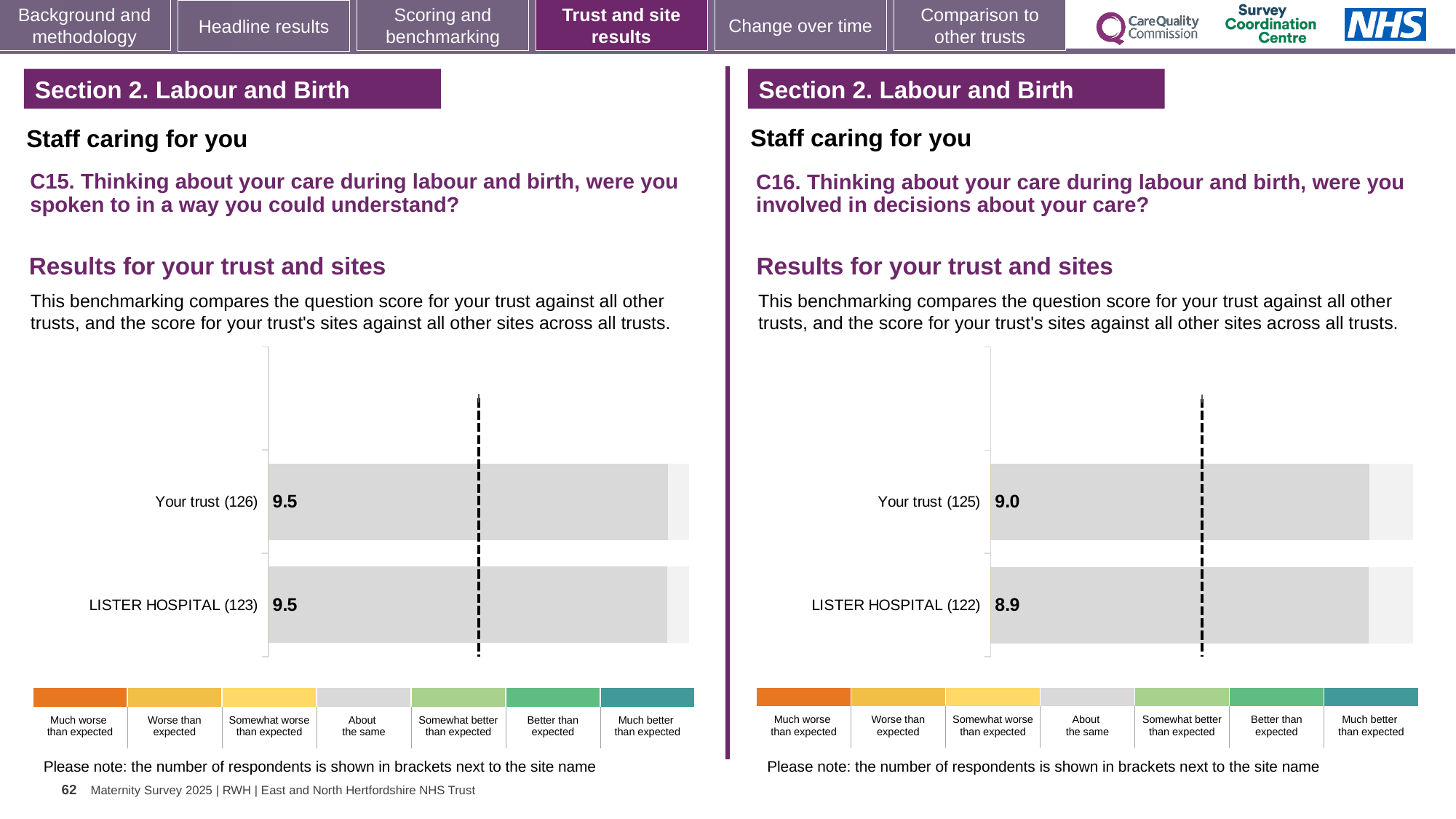
How many bars are plotted on the right chart (C16)? 2 On the right chart (C16), how many respondents are shown in brackets for Your trust? 125 On the right chart (C16), what is the score for LISTER HOSPITAL? 8.9 On the right chart (C16), what is the difference between the score for Your trust and the score for LISTER HOSPITAL? 0.1 On the right chart (C16), which has the higher score, Your trust or LISTER HOSPITAL? Your trust On the left chart (C15), what is the score for Your trust? 9.5 What kind of chart is used on the left (C15)? Bar chart On the left chart (C15), what is the difference between the score for Your trust and the score for LISTER HOSPITAL? 0 On the left chart (C15), what is the score for LISTER HOSPITAL? 9.5 On the left chart (C15), how many respondents are shown in brackets for LISTER HOSPITAL? 123 How many bars are plotted on the left chart (C15)? 2 On the right chart (C16), what is the score for Your trust? 9.0